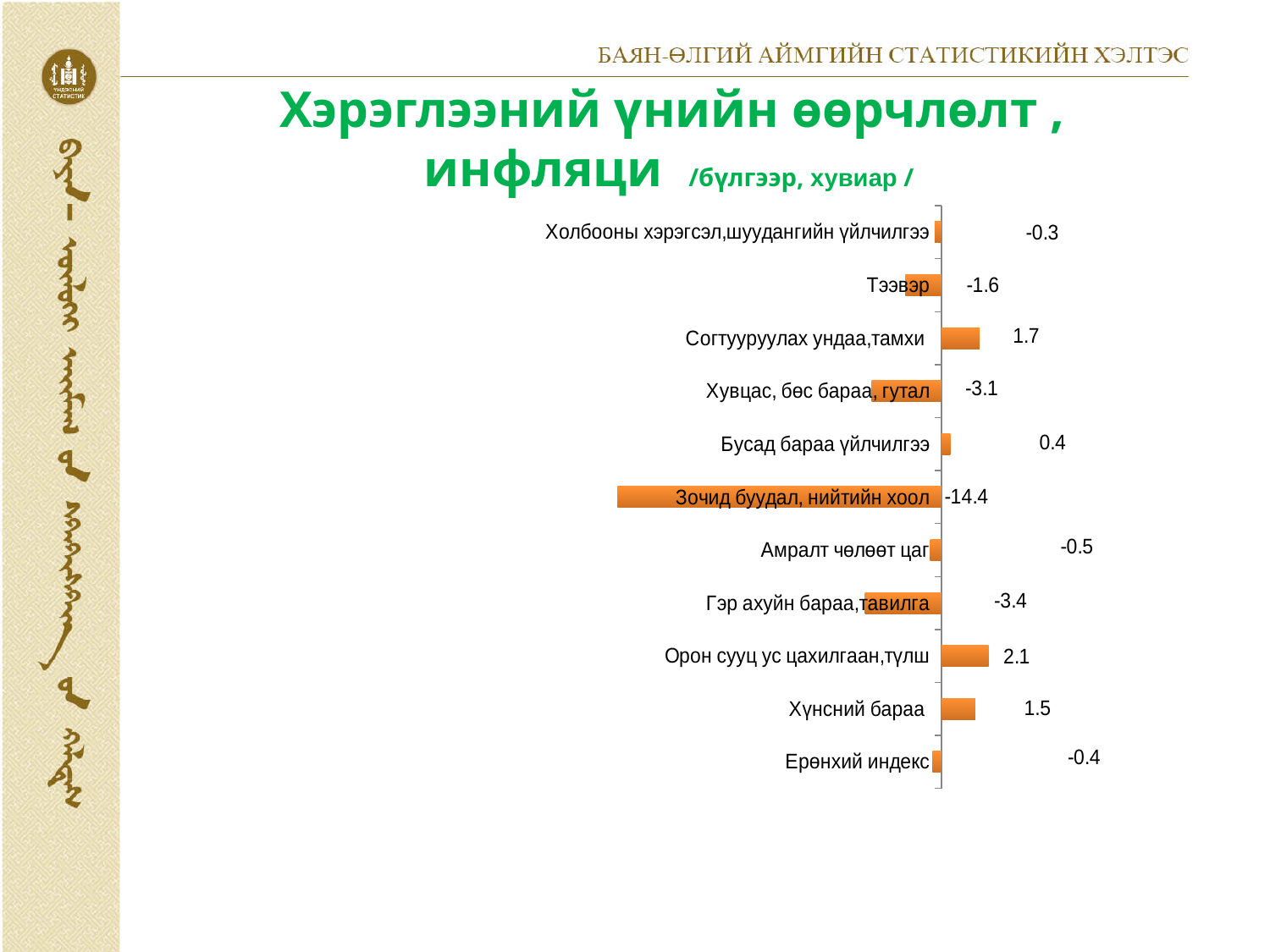
What is the value for Ерөнхий индекс? -0.4 What is the value for Хүнсний бараа? 1.5 How many categories are plotted in the chart? 11 What is the difference between the values for Орон сууц ус цахилгаан,түлш and Хүнсний бараа? 0.6 Which category has the highest value? Орон сууц ус цахилгаан,түлш What is the value for Зочид буудал, нийтийн хоол? -14.4 What type of chart is shown on the slide? bar chart What is the value for Гэр ахуйн бараа,тавилга? -3.4 What is the title of the chart on the slide? Хэрэглээний үнийн өөрчлөлт, инфляци /бүлгээр, хувиар/ Which is larger, the value for Согтууруулах ундаа,тамхи or the value for Хүнсний бараа? Согтууруулах ундаа,тамхи What is the value for Орон сууц ус цахилгаан,түлш? 2.1 Which category has the lowest value? Зочид буудал, нийтийн хоол